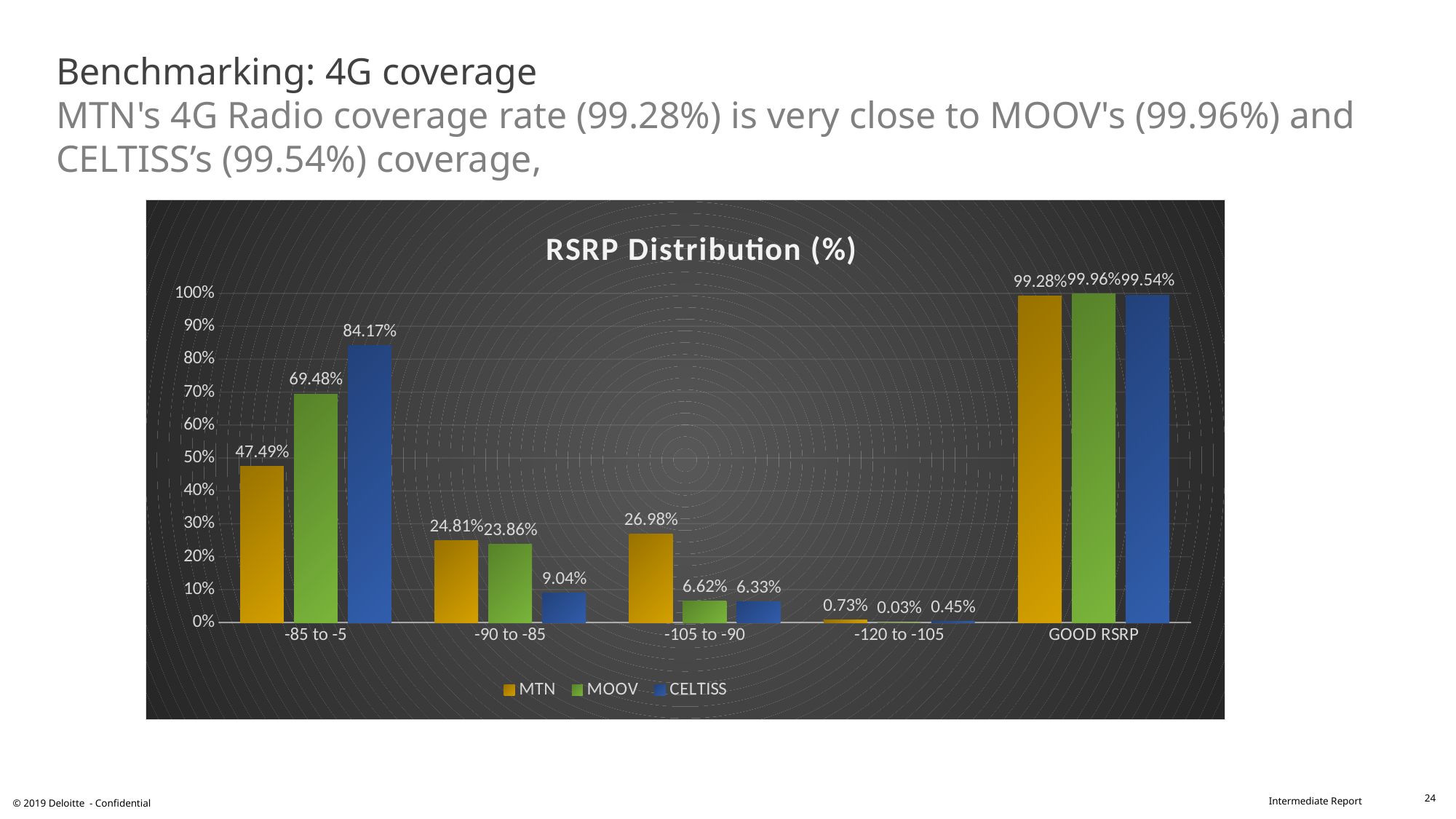
What is the difference between the CELTISS and MTN values in the -85 to -5 category? 36.68% What is the CELTISS value for the -85 to -5 category? 84.17% What is the MTN value for the -85 to -5 category? 47.49% Which is larger in the -105 to -90 category, the MTN value or the MOOV value? MTN What is the MOOV value for the -105 to -90 category? 6.62% Which series has the highest value in the -85 to -5 category? CELTISS How many series does the legend list? 3 What type of chart is shown? Bar chart Which series has the lowest value in the -120 to -105 category? MOOV How many categories are shown on the x axis? 5 What is the MOOV value for GOOD RSRP? 99.96% Is the MOOV value for the -85 to -5 category greater or less than 60%? greater